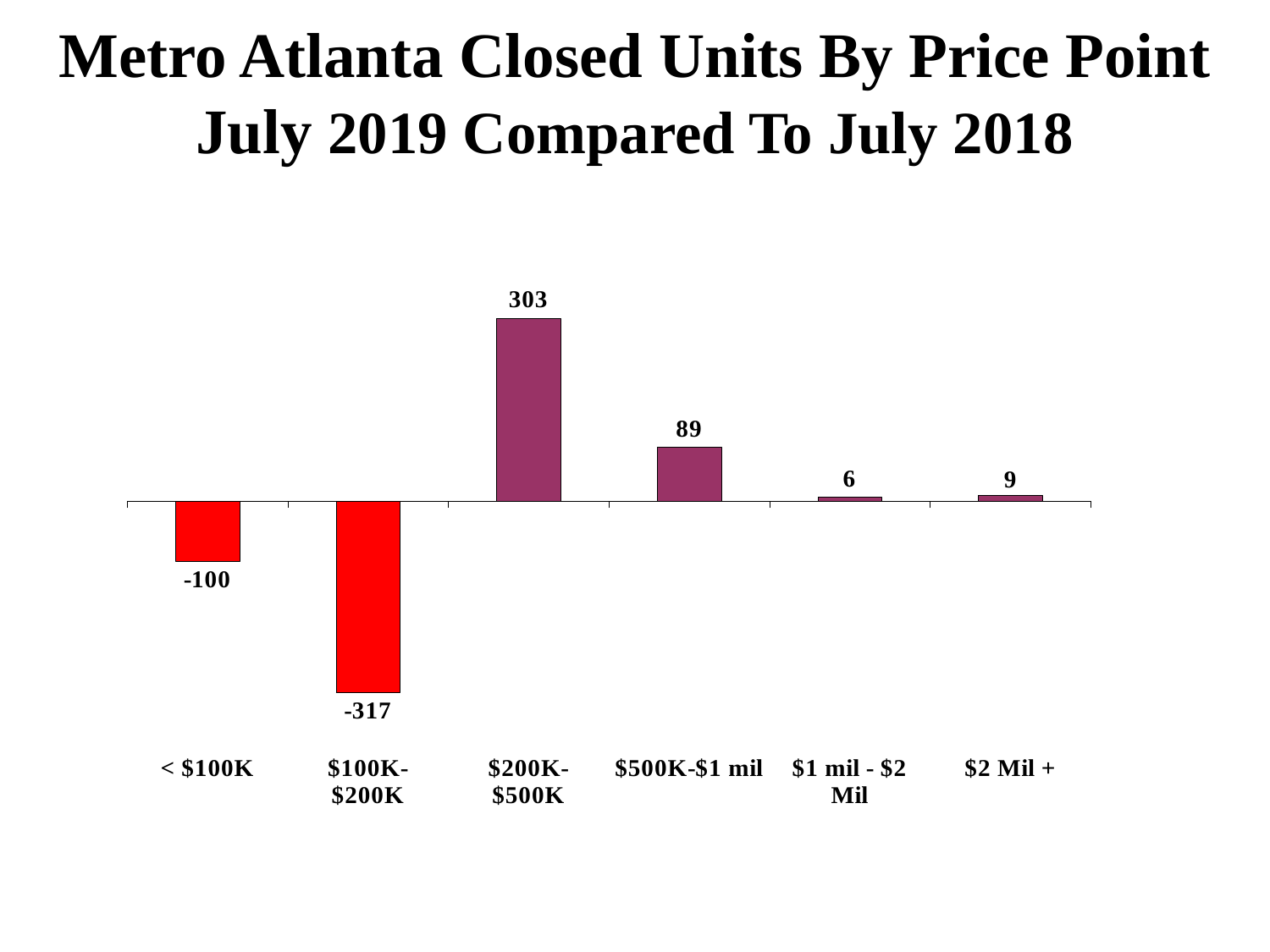
How many price point categories are shown on the chart? 6 What is the value for the $200K-$500K price point? 303 What is the value for the $2 Mil + price point? 9 Which is larger, the value for $1 mil - $2 Mil or the value for $2 Mil +? $2 Mil + What is the value for the $500K-$1 mil price point? 89 What is the difference between the values for $200K-$500K and $500K-$1 mil? 214 What kind of chart is shown on the slide? Bar chart How many price points have negative values? 2 Which price point has the highest value? $200K-$500K What is the value for the < $100K price point? -100 What is the value for the $100K-$200K price point? -317 Which price point has the lowest value? $100K-$200K